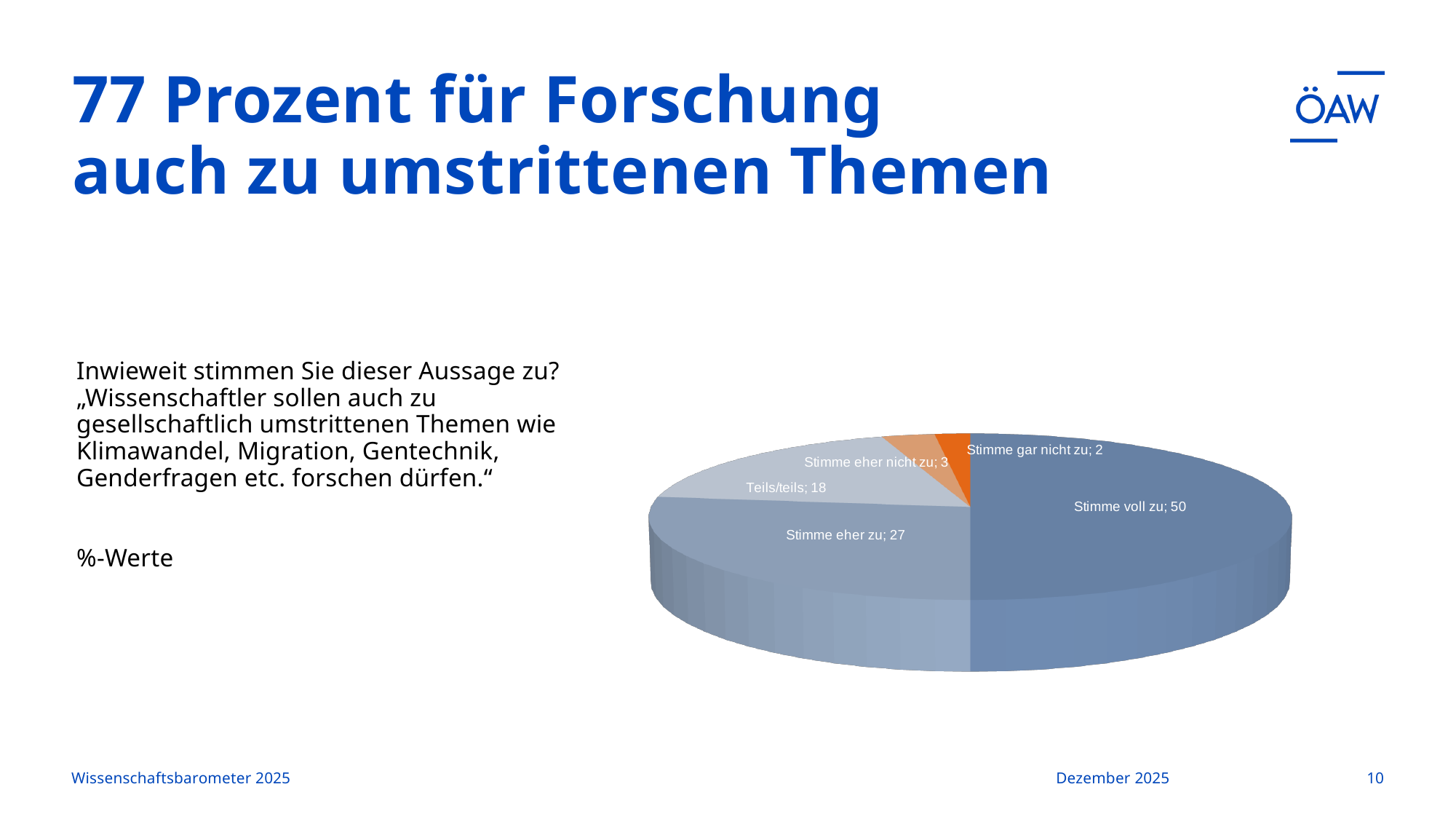
What is the combined value of "Stimme voll zu" and "Stimme eher zu"? 77 Which category has the smallest slice? Stimme gar nicht zu How many slices does the pie chart have? 5 Which category has the largest slice? Stimme voll zu What kind of chart is shown on the slide? Pie chart Which is larger, the value for "Teils/teils" or the value for "Stimme eher nicht zu"? Teils/teils What is the value for "Stimme voll zu"? 50 What is the value for "Stimme eher zu"? 27 What is the value for "Stimme gar nicht zu"? 2 What is the value for "Teils/teils"? 18 What is the difference between the values for "Stimme voll zu" and "Stimme eher zu"? 23 What is the value for "Stimme eher nicht zu"? 3